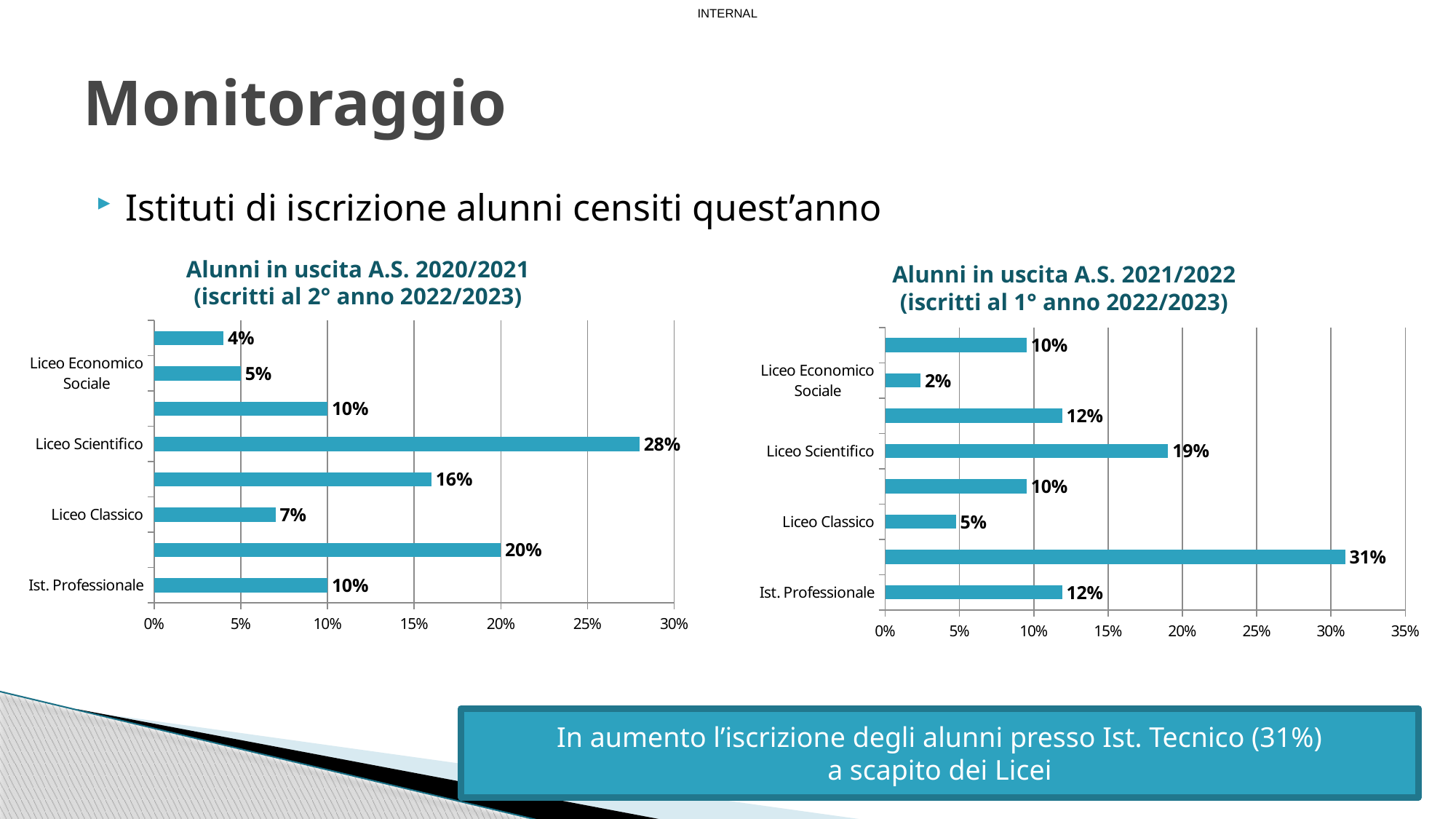
What is the difference between the Liceo Scientifico value in the left chart (A.S. 2020/2021) and the Liceo Scientifico value in the right chart (A.S. 2021/2022)? 9% In the chart titled 'Alunni in uscita A.S. 2020/2021', what is the value for Liceo Scientifico? 28% How many bars are plotted in the chart titled 'Alunni in uscita A.S. 2020/2021'? 8 What kind of chart is the chart titled 'Alunni in uscita A.S. 2021/2022'? Bar chart In the chart titled 'Alunni in uscita A.S. 2021/2022', which category has the lowest value? Liceo Economico Sociale In the chart titled 'Alunni in uscita A.S. 2020/2021', what is the value for Liceo Classico? 7% In the chart titled 'Alunni in uscita A.S. 2020/2021', which is larger: Liceo Classico or Ist. Professionale? Ist. Professionale In the chart titled 'Alunni in uscita A.S. 2021/2022', what is the value for Ist. Professionale? 12% In the chart titled 'Alunni in uscita A.S. 2021/2022', is the value for Liceo Scientifico greater or less than 15%? greater What is the maximum value shown on the x axis of the chart titled 'Alunni in uscita A.S. 2021/2022'? 35% In the chart titled 'Alunni in uscita A.S. 2020/2021', which category has the highest value? Liceo Scientifico In the chart titled 'Alunni in uscita A.S. 2021/2022', what is the value for Liceo Economico Sociale? 2%